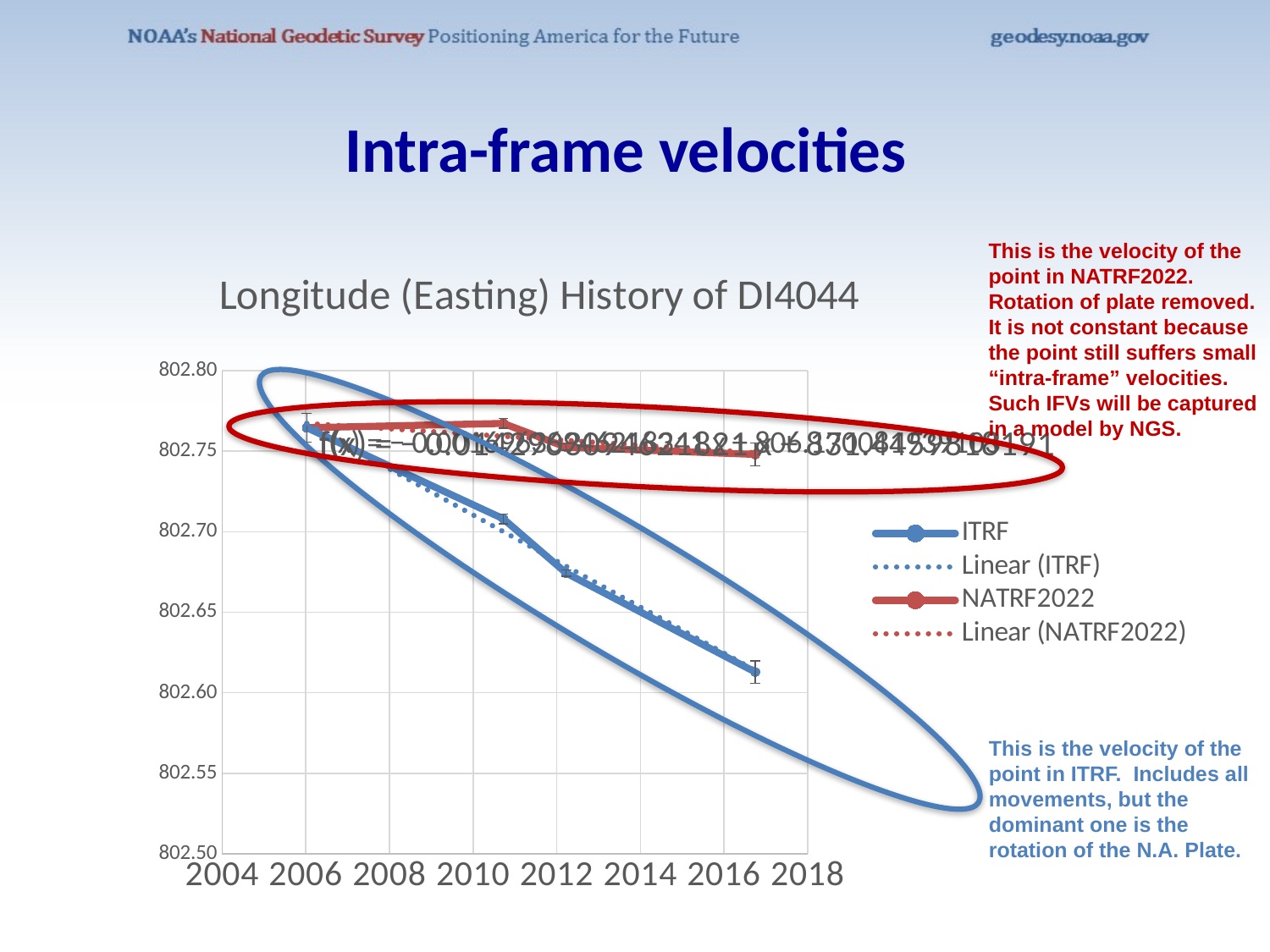
Does the ITRF series rise or fall as the years increase along the x axis? fall Is the NATRF2022 value at its last plotted point (around 2016) greater or less than 802.70? greater How many data points are plotted for the ITRF series? 4 Which series is drawn in red on the chart? NATRF2022 Is the ITRF value at its last plotted point (around 2016) greater or less than 802.65? less How many series does the chart legend list? 4 Around 2016, which series has the larger value, ITRF or NATRF2022? NATRF2022 Around 2012, is the ITRF value greater or less than 802.70? less What kind of chart is shown on the slide? line chart What is the title of the chart? Longitude (Easting) History of DI4044 Which series shows the steeper decline over the period, ITRF or NATRF2022? ITRF